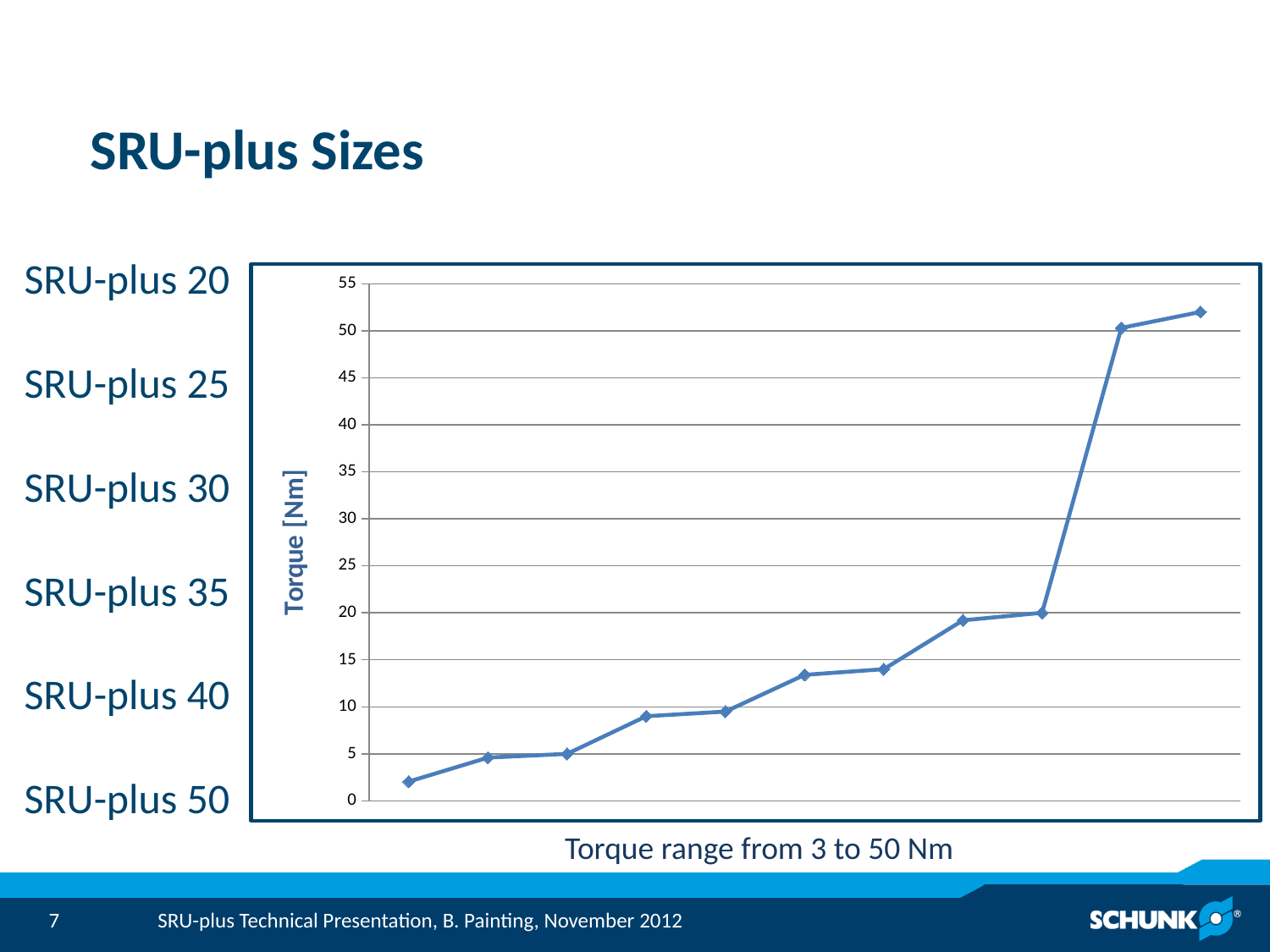
Is the value of the last (rightmost) point greater or less than 50? greater What is the highest value shown on the vertical axis scale? 55 Is the value of the first (leftmost) point greater or less than 5? less Which point on the line has the lowest value? the leftmost (first) point Is the value of the sixth point from the left greater or less than 15? less How many data points are plotted on the line? 11 What kind of chart is shown on the slide? line chart Which point has the highest value, the leftmost or the rightmost? rightmost What is the title of the vertical axis? Torque [Nm] Do the values rise or fall from left to right along the x axis? rise